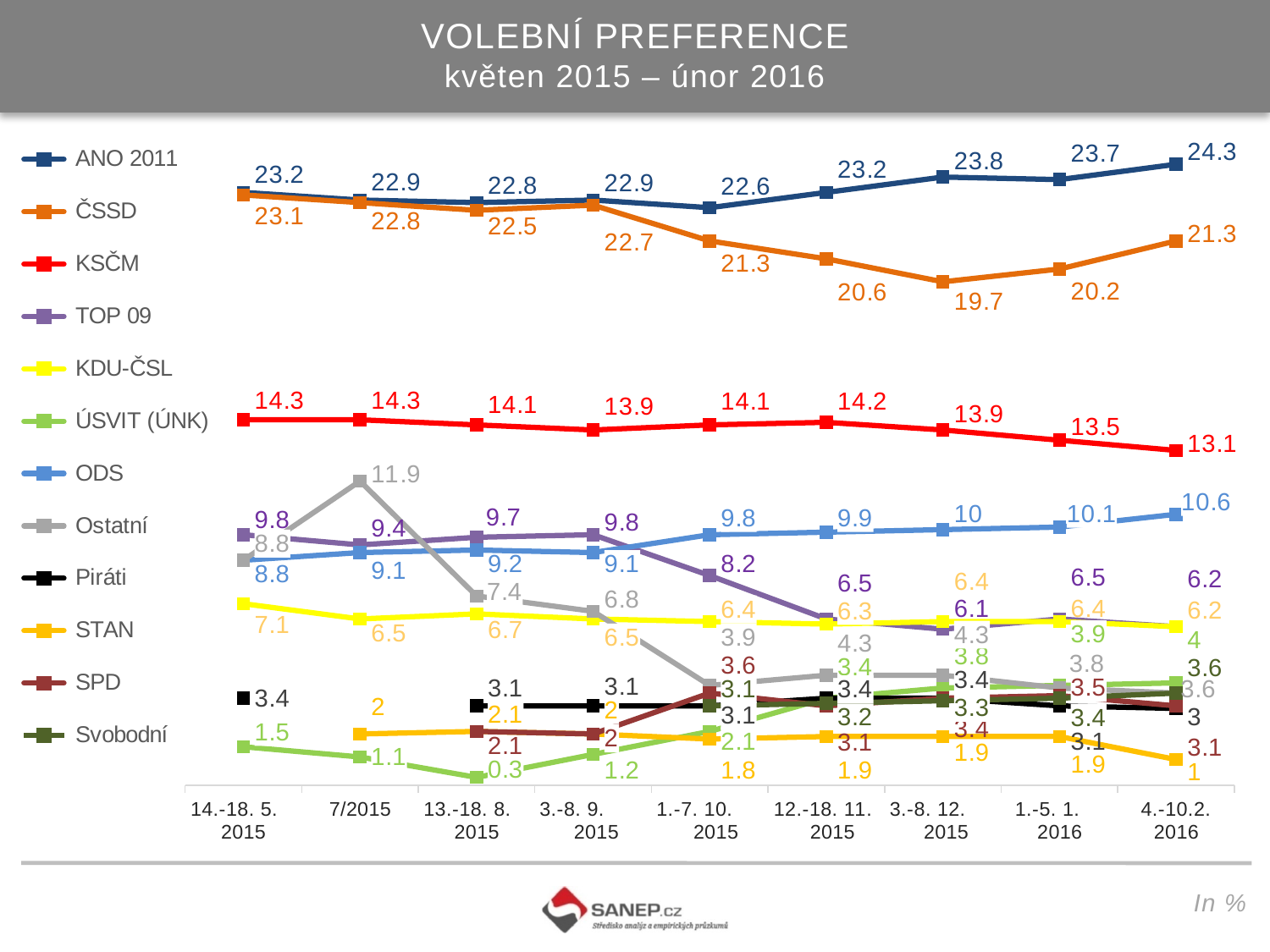
What is the value for Ostatní in the 7/2015 period? 11.9 What is the value for ANO 2011 in the 4.-10.2. 2016 period? 24.3 How many series does the legend list? 12 What is the title of the chart? VOLEBNÍ PREFERENCE květen 2015 – únor 2016 In which period does ANO 2011 reach its highest value? 4.-10.2. 2016 Does the KSČM line rise or fall from the 12.-18. 11. 2015 period to the 4.-10.2. 2016 period? fall In which period does ČSSD reach its lowest value? 3.-8. 12. 2015 What is the difference between ANO 2011 and ČSSD in the 4.-10.2. 2016 period? 3 What type of chart is shown on the slide? line chart What is the value for ČSSD in the 3.-8. 12. 2015 period? 19.7 Which is larger in the 14.-18. 5. 2015 period, TOP 09 or KDU-ČSL? TOP 09 How many survey periods are shown along the x axis? 9